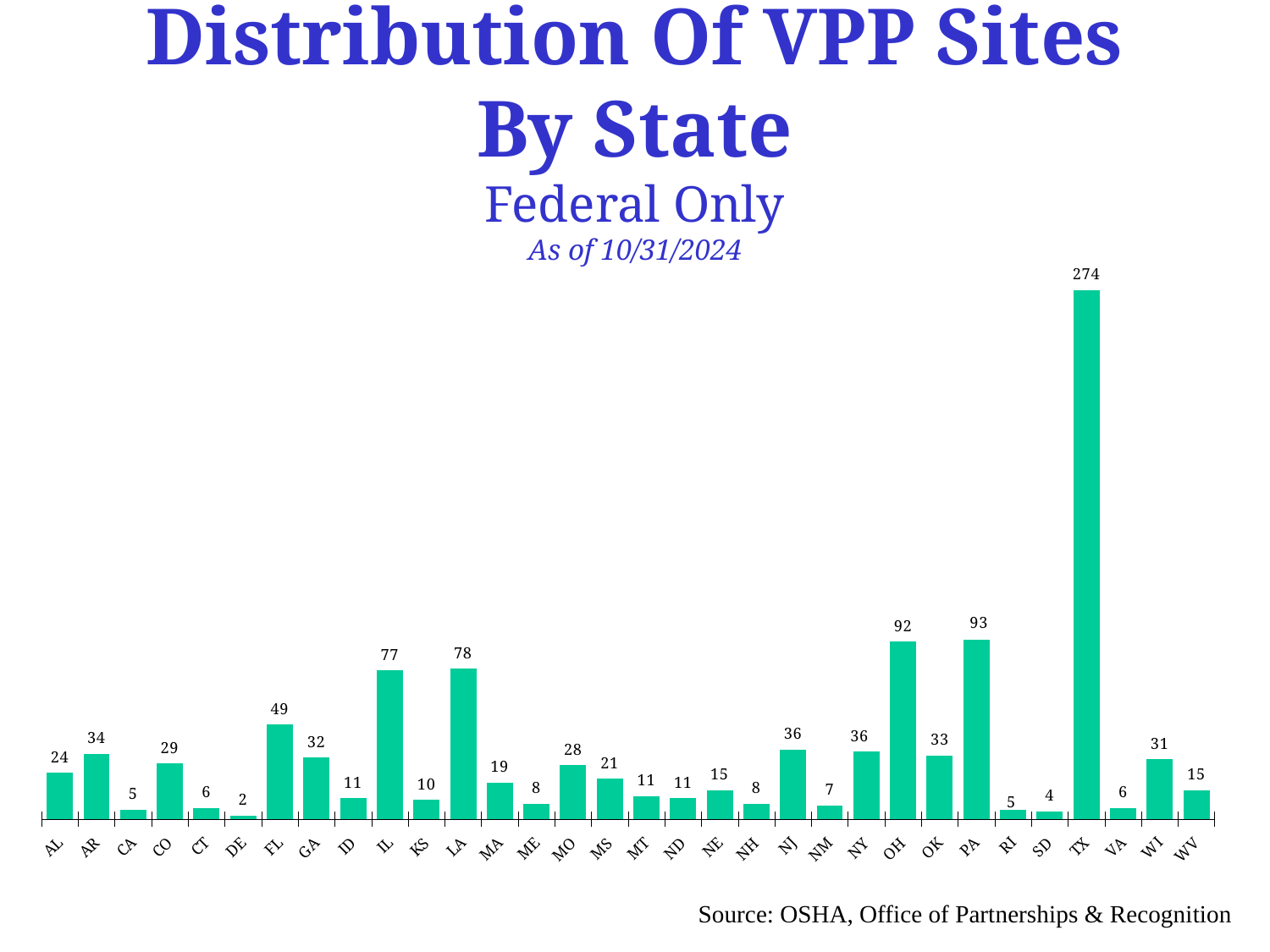
What is the difference between the values for TX and PA? 181 How many states are shown on the x axis? 32 What date is the data on the chart current as of? 10/31/2024 What is the value shown for Ohio (OH)? 92 What is the value shown for Florida (FL)? 49 How many VPP sites does Texas (TX) have? 274 What is the value shown for Louisiana (LA)? 78 Which state has the lowest number of VPP sites? DE What is the difference between the values for PA and OH? 1 Which has a larger value, IL or FL? IL What type of chart is shown on the slide? Bar chart Which state has the highest number of VPP sites? TX